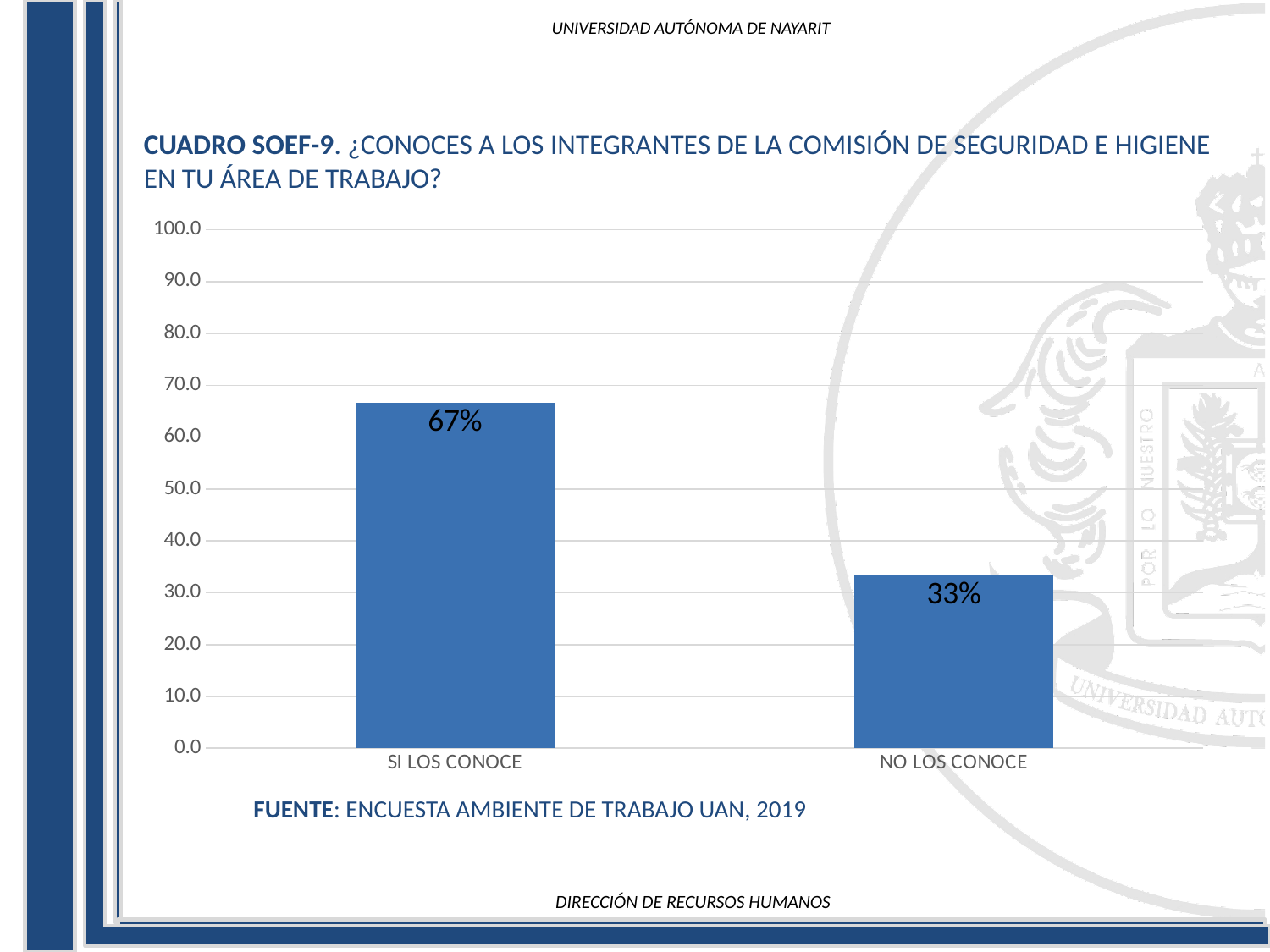
Is the value for NO LOS CONOCE greater or less than 40.0? less What is the difference between the values for SI LOS CONOCE and NO LOS CONOCE? 34% Which category has the lowest value? NO LOS CONOCE Is the value for SI LOS CONOCE greater or less than 60.0? greater What kind of chart is shown on the slide? Bar chart What is the value for SI LOS CONOCE? 67% What is the source cited below the chart? ENCUESTA AMBIENTE DE TRABAJO UAN, 2019 Which is larger, the value for SI LOS CONOCE or the value for NO LOS CONOCE? SI LOS CONOCE Which category has the highest value? SI LOS CONOCE What is the value for NO LOS CONOCE? 33% What is the maximum value shown on the vertical axis? 100.0 How many categories are shown in the chart? 2